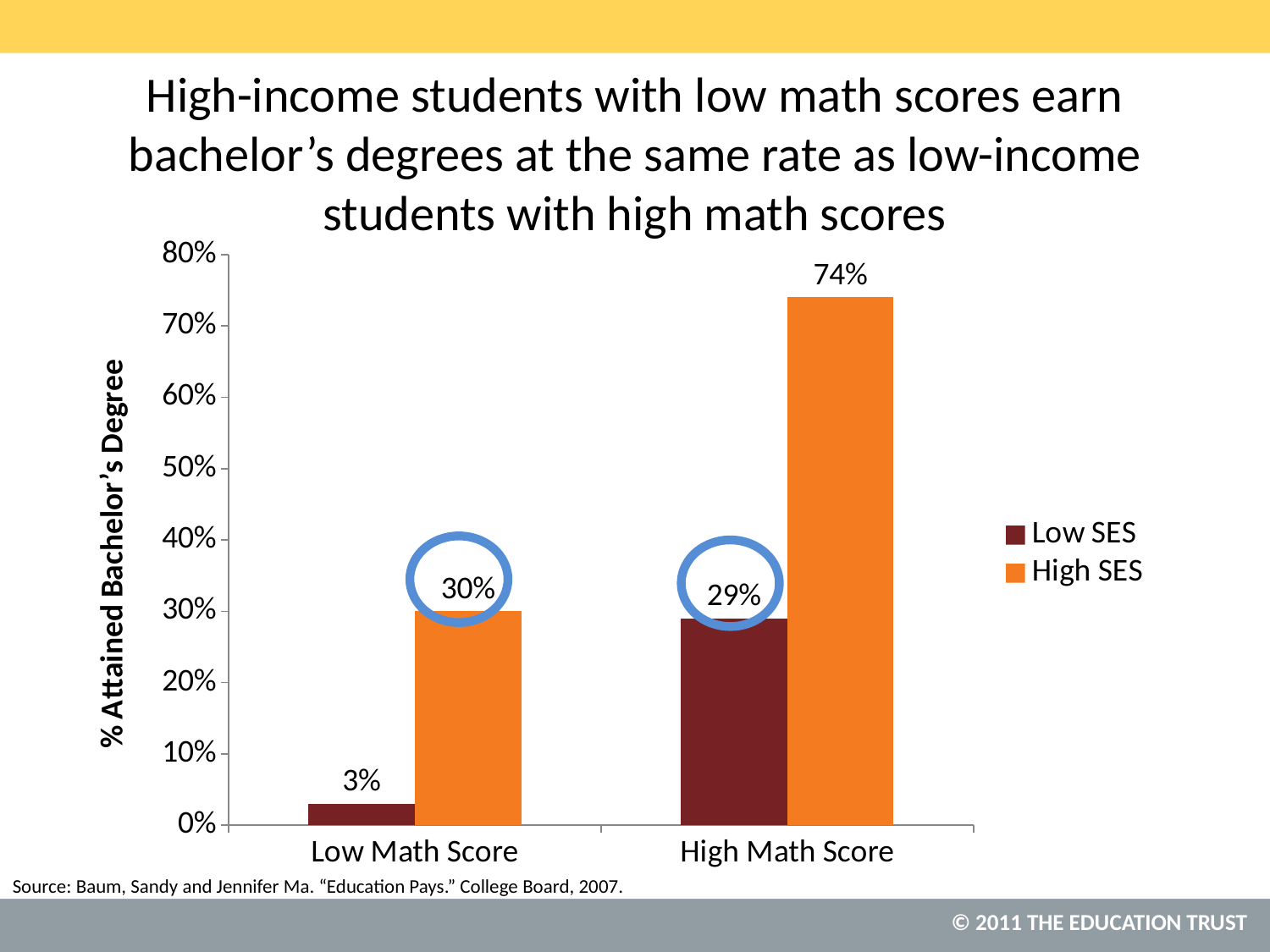
What kind of chart is shown on the slide? Bar chart What is the difference between the High SES and Low SES values in the High Math Score category? 45% What percentage of High SES students with a High Math Score attained a bachelor's degree? 74% Which bar has the lowest value on the chart? Low SES, Low Math Score What is the label of the vertical axis? % Attained Bachelor's Degree What percentage of Low SES students with a Low Math Score attained a bachelor's degree? 3% How many series does the legend list? 2 What is the difference between the High SES and Low SES values in the Low Math Score category? 27% Which bar has the highest value on the chart? High SES, High Math Score What is the value for High SES students in the Low Math Score category? 30% Which is larger: the Low SES value for High Math Score or the High SES value for High Math Score? High SES value for High Math Score What is the value for Low SES students in the High Math Score category? 29%